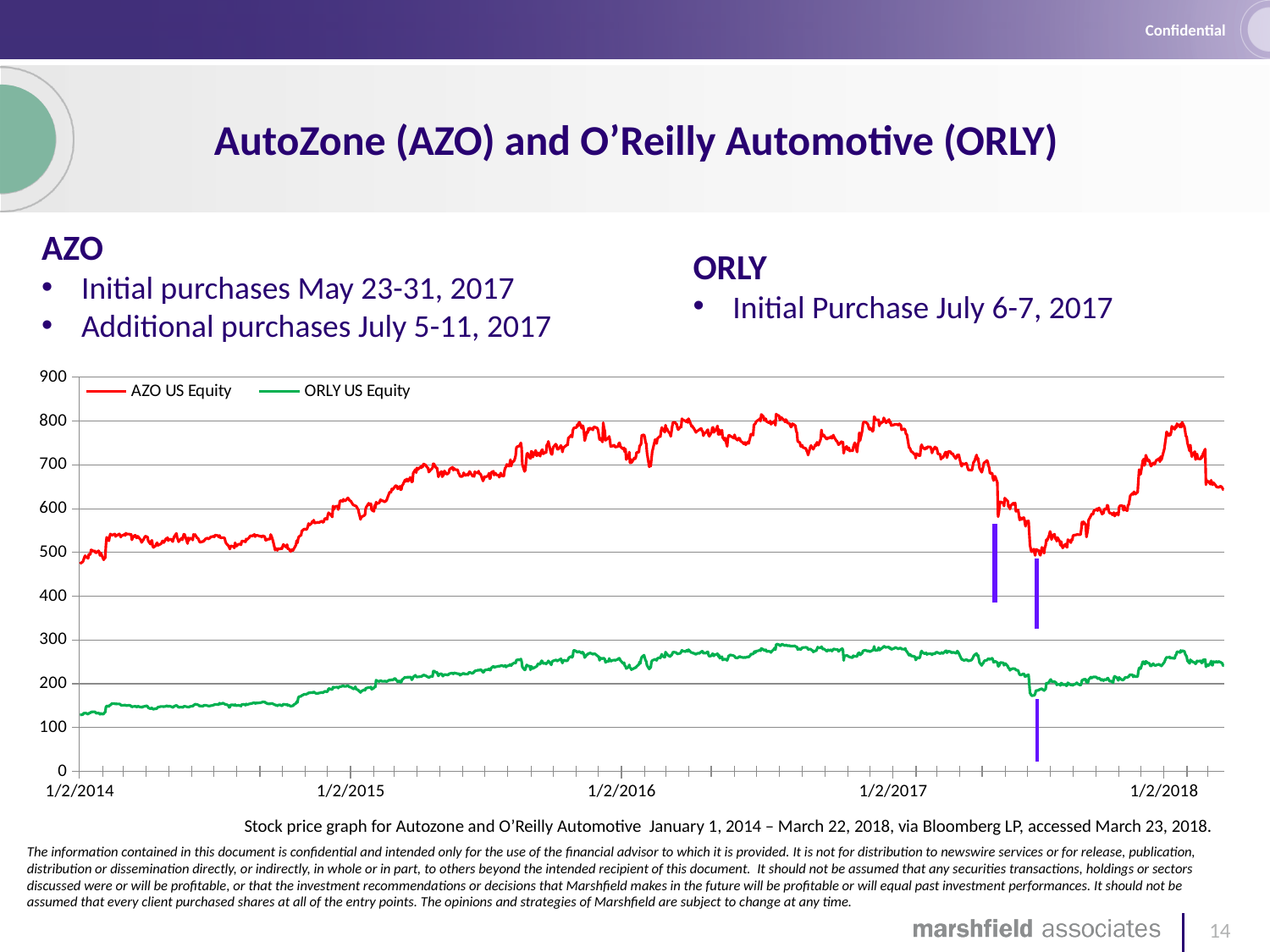
How many series does the chart legend list? 2 Does the AZO US Equity line ever rise above 800 on the chart? yes How many date labels are shown along the chart's horizontal axis? 5 Is the value of AZO US Equity at 1/2/2016 greater or less than 700? greater Does the ORLY US Equity line rise or fall between 1/2/2014 and 1/2/2016? rise What are the two series named in the chart legend? AZO US Equity and ORLY US Equity Is the highest value reached by ORLY US Equity greater or less than 300? less Which series has the higher values throughout the chart, AZO US Equity or ORLY US Equity? AZO US Equity What is the highest value shown on the chart's vertical axis? 900 What kind of chart is shown on the slide? line chart